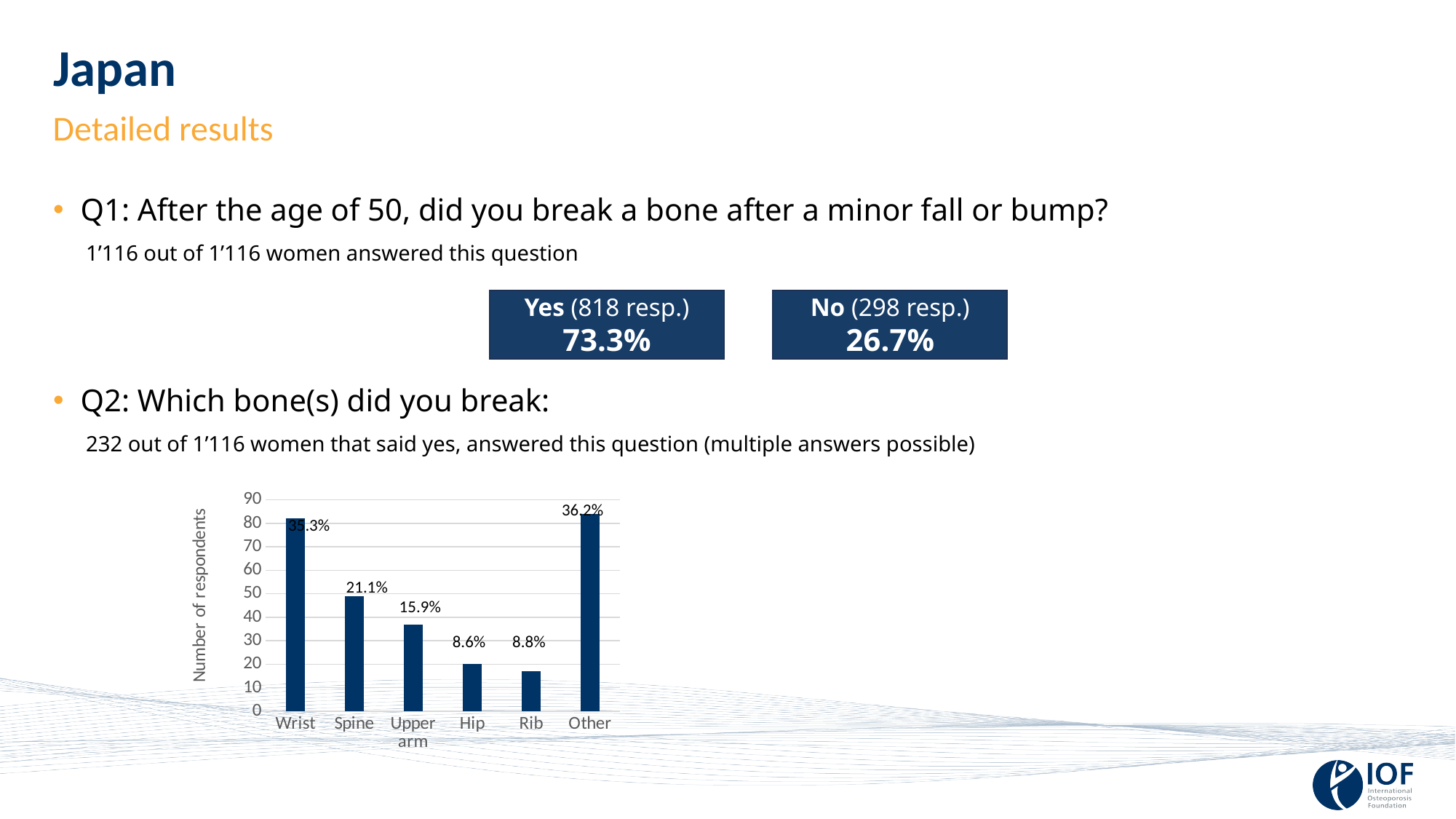
Which category has the highest percentage label in the Q2 bar chart? Other What is the y-axis title of the Q2 bar chart? Number of respondents What percentage label is shown for Spine in the Q2 bar chart? 21.1% Is the number of respondents for Upper arm in the Q2 bar chart greater or less than 40? less What percentage label is shown for Upper arm in the Q2 bar chart? 15.9% What percentage label is shown for Wrist in the Q2 bar chart? 35.3% What percentage label is shown for Rib in the Q2 bar chart? 8.8% What percentage label is shown for Hip in the Q2 bar chart? 8.6% What kind of chart is used for Q2? bar chart Which has a larger percentage label in the Q2 bar chart, Spine or Upper arm? Spine What is the difference in percentage points between the Wrist and Spine labels in the Q2 bar chart? 14.2 How many bone categories are shown in the Q2 bar chart? 6